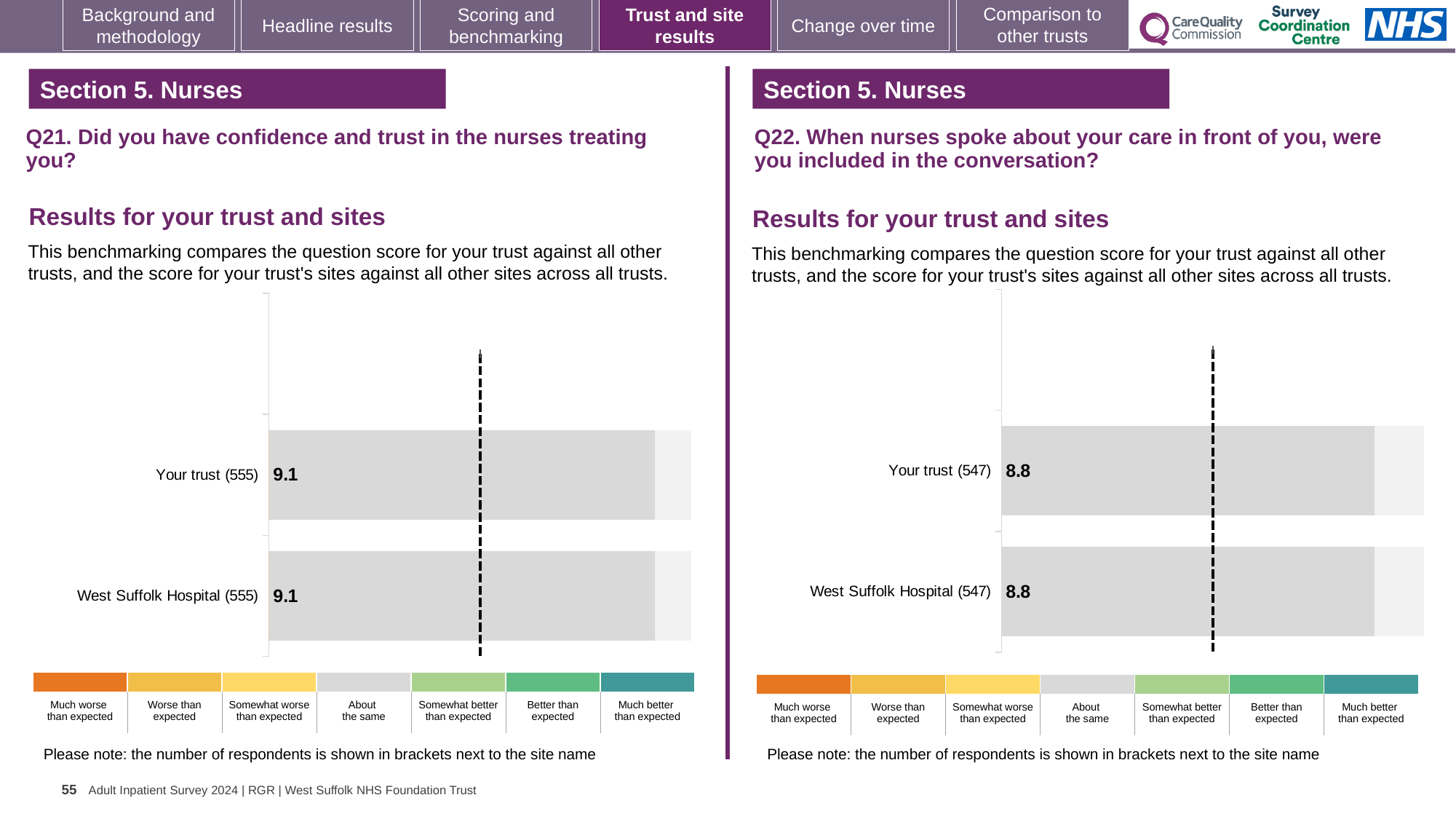
In the Q21 chart on the left, what is the score for Your trust? 9.1 Is the score for Your trust in the Q21 chart on the left larger than, smaller than, or equal to the score for Your trust in the Q22 chart on the right? Larger In the Q22 chart on the right, how many respondents are shown in brackets next to West Suffolk Hospital? 547 How many bars are plotted in the Q22 chart on the right? 2 What kind of chart is the Q21 chart on the left? Bar chart In the Q22 chart on the right, what is the difference between the score for Your trust and the score for West Suffolk Hospital? 0.0 In the Q21 chart on the left, how many respondents are shown in brackets next to Your trust? 555 In the Q22 chart on the right, what is the score for West Suffolk Hospital? 8.8 How many bars are plotted in the Q21 chart on the left? 2 In the Q21 chart on the left, what is the score for West Suffolk Hospital? 9.1 In the Q21 chart on the left, what is the difference between the score for Your trust and the score for West Suffolk Hospital? 0.0 In the Q22 chart on the right, what is the score for Your trust? 8.8